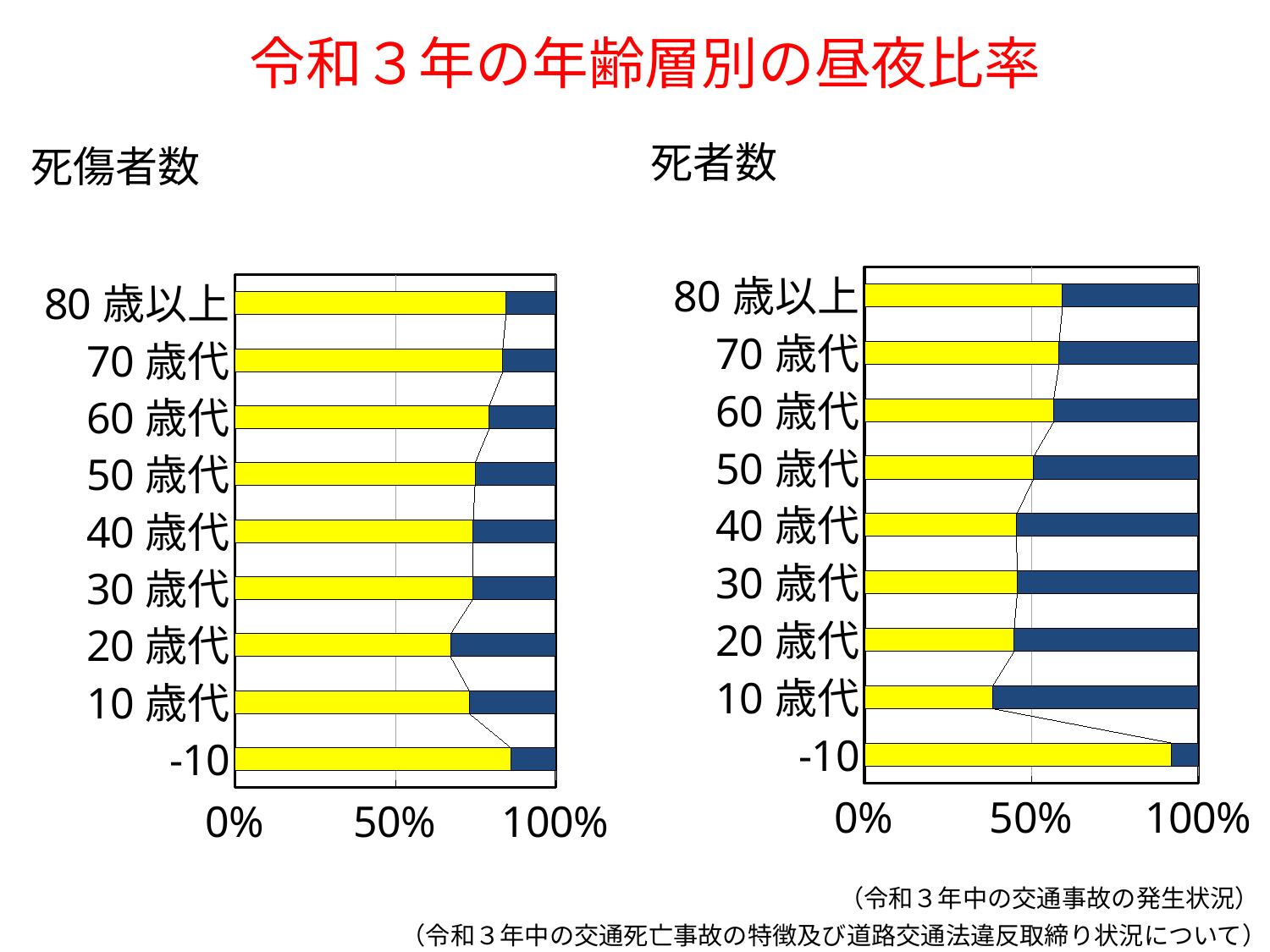
In the right chart (死者数), is the yellow segment for -10 greater or less than 50%? greater In the right chart (死者数), is the yellow segment for 10 歳代 greater or less than 50%? less In the right chart (死者数), which age category has the largest yellow segment? -10 What kind of chart is the left chart titled 死傷者数? bar chart What two colours are used for the bar segments in the charts? yellow and dark blue In the left chart (死傷者数), is the yellow segment for 20 歳代 greater or less than 50%? greater How many age categories are shown in the right chart titled 死者数? 9 In the right chart (死者数), which age category has the smallest yellow segment? 10 歳代 In the left chart (死傷者数), which age category has the smallest yellow segment? 20 歳代 In the right chart (死者数), which has the larger yellow segment, -10 or 10 歳代? -10 What is the title of the slide above the two charts? 令和３年の年齢層別の昼夜比率